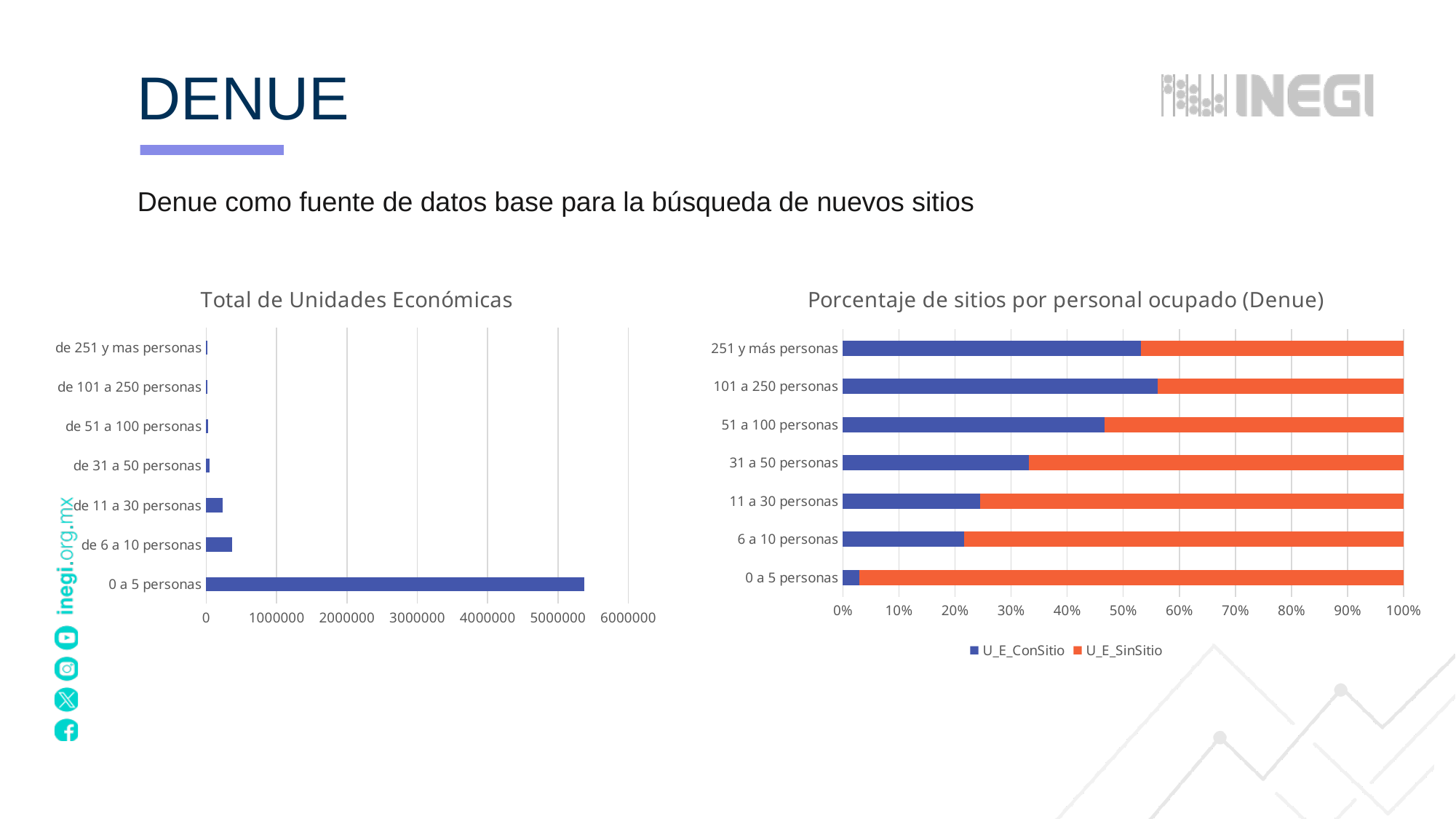
What are the legend entries of the 'Porcentaje de sitios por personal ocupado (Denue)' chart? U_E_ConSitio and U_E_SinSitio How many series does the legend of the 'Porcentaje de sitios por personal ocupado (Denue)' chart list? 2 In the 'Total de Unidades Económicas' chart, which category has the highest value? 0 a 5 personas In the 'Porcentaje de sitios por personal ocupado (Denue)' chart, is the U_E_ConSitio value for '0 a 5 personas' greater or less than 10%? less In the 'Porcentaje de sitios por personal ocupado (Denue)' chart, which category has the lowest U_E_ConSitio share? 0 a 5 personas In the 'Porcentaje de sitios por personal ocupado (Denue)' chart, which is larger: the U_E_ConSitio share for '251 y más personas' or for '0 a 5 personas'? 251 y más personas How many categories does the 'Total de Unidades Económicas' chart show? 7 In the 'Porcentaje de sitios por personal ocupado (Denue)' chart, which colour represents U_E_SinSitio? orange In the 'Total de Unidades Económicas' chart, is the value for 'de 6 a 10 personas' greater or less than 1000000? less What kind of chart is the 'Total de Unidades Económicas' chart? bar chart In the 'Total de Unidades Económicas' chart, is the value for '0 a 5 personas' greater or less than 5000000? greater